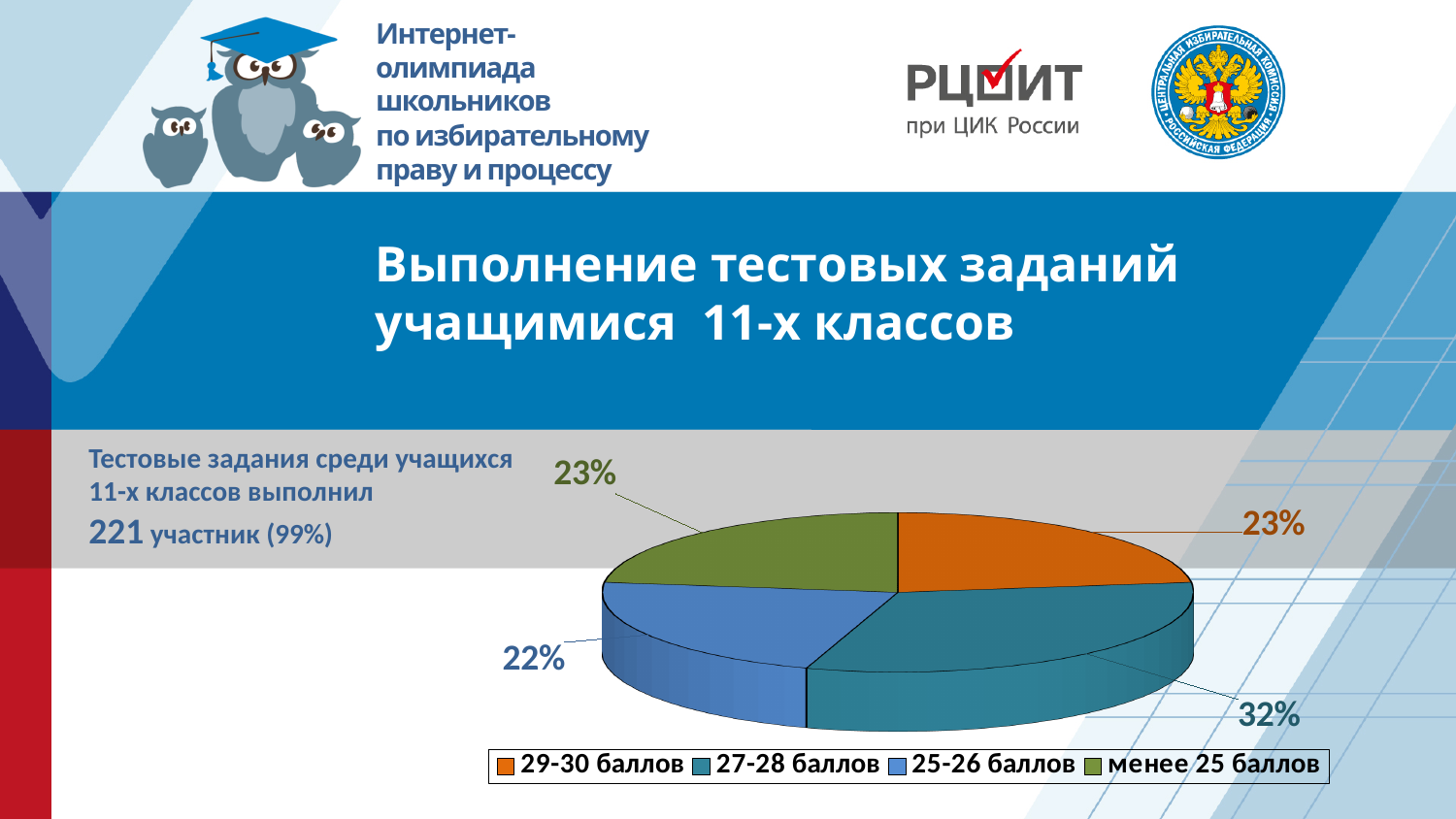
What is the difference in percentage points between the 27-28 баллов slice and the 25-26 баллов slice? 10 What share of participants scored 29-30 баллов? 23% What share of participants scored 27-28 баллов? 32% What share of participants scored менее 25 баллов? 23% What type of chart is shown on the slide? pie chart Which slice is larger: 27-28 баллов or 29-30 баллов? 27-28 баллов Which score category has the largest share of the pie? 27-28 баллов How many slices does the pie chart have? 4 What share of participants scored 25-26 баллов? 22% Which score category has the smallest share of the pie? 25-26 баллов How many entries does the legend list? 4 What colour is the slice for менее 25 баллов? green